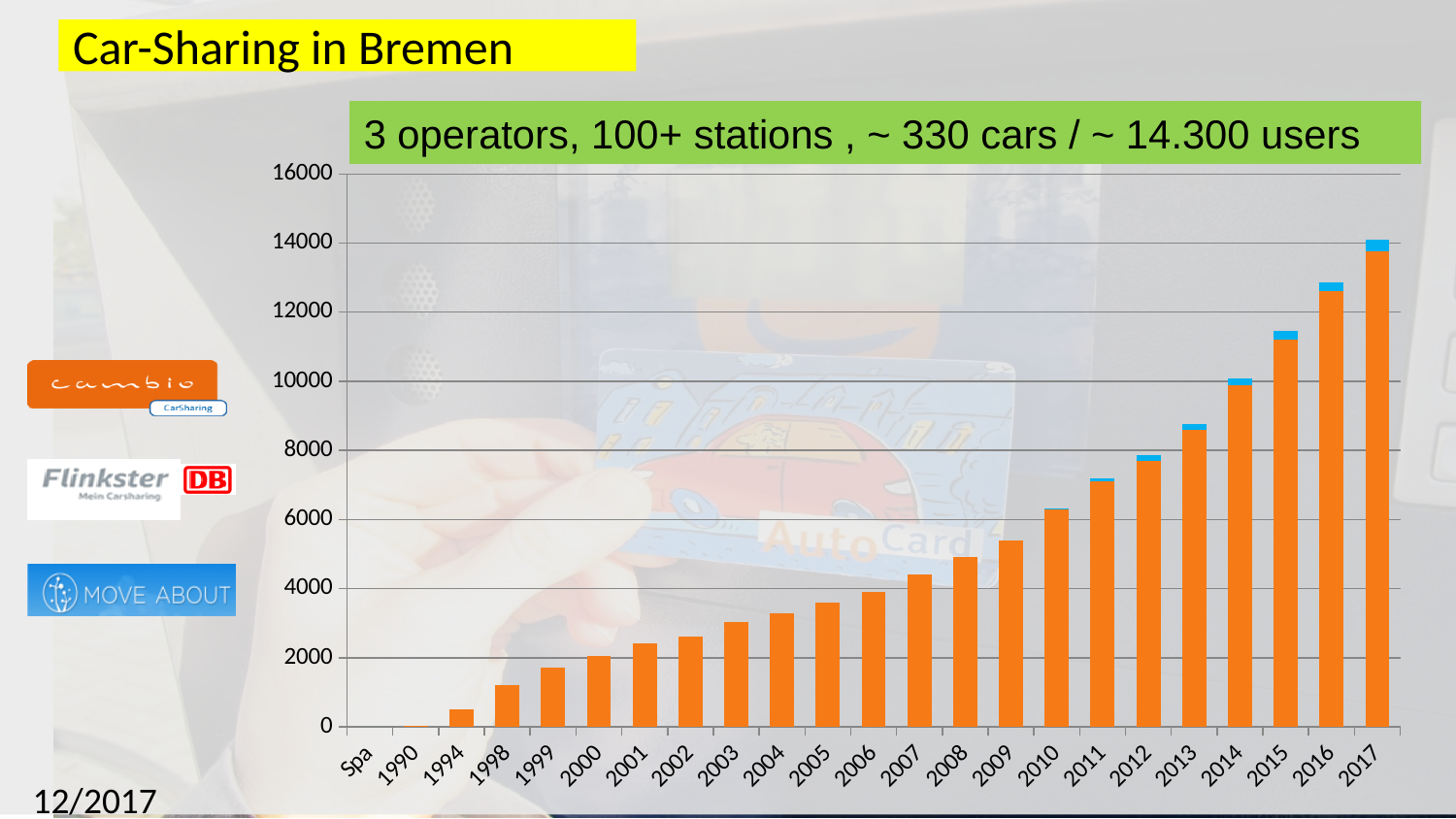
Is the value for 2005 greater or less than 4000? less How many categories are shown on the x axis of the chart? 23 Is the value for 2015 greater or less than 10000? greater Do the values generally rise or fall from left to right along the x axis? rise Is the value for 2016 greater or less than 12000? greater Which is larger, the value for 2016 or the value for 2010? 2016 What text appears in the green box above the chart? 3 operators, 100+ stations , ~ 330 cars / ~ 14.300 users What kind of chart is shown on the slide? bar chart Which year has the highest bar in the chart? 2017